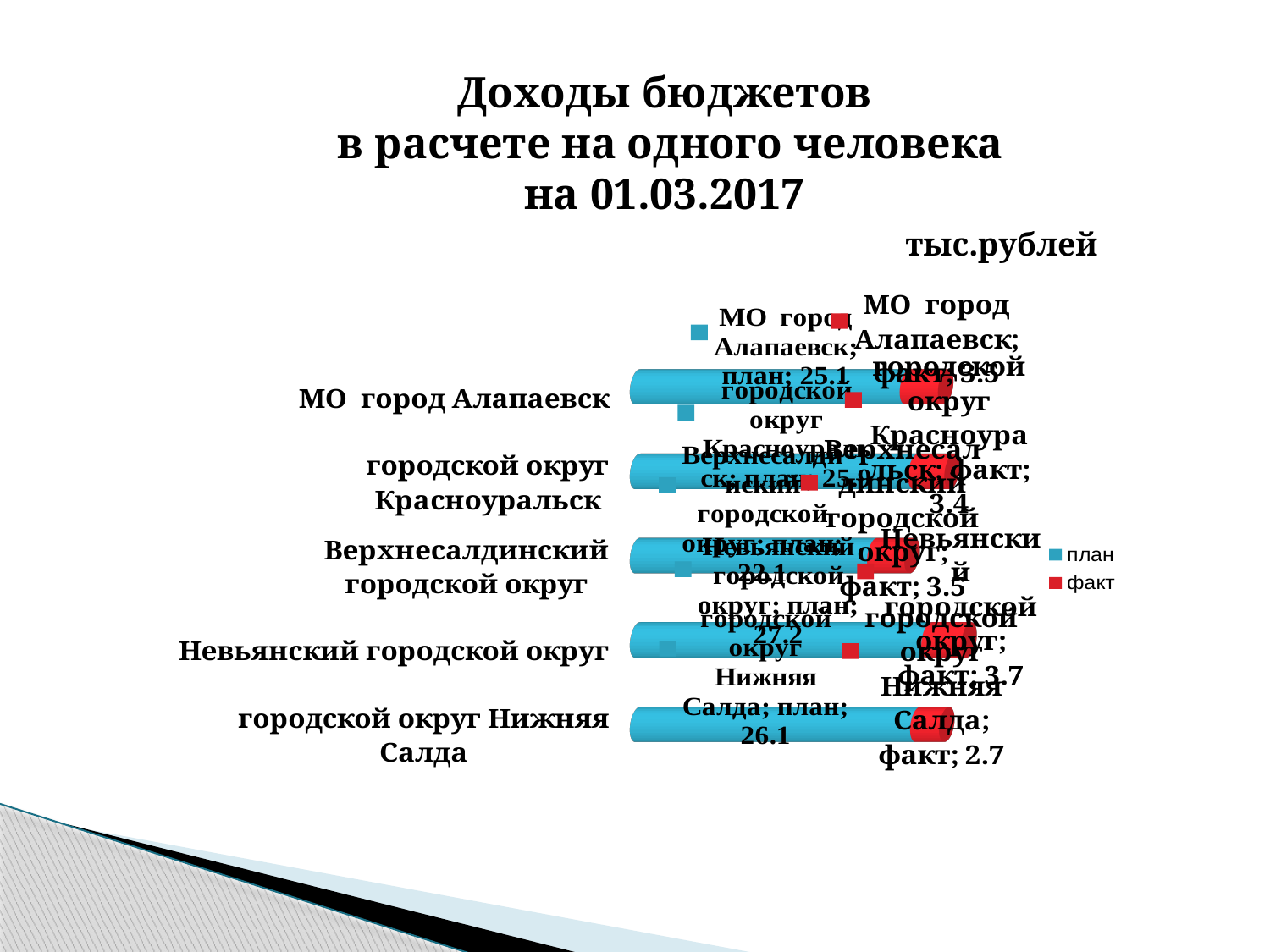
How many categories (municipalities) are shown on the chart? 5 What kind of chart is shown on the slide? bar chart What is the план value for Невьянский городской округ? 27.2 Which is larger for городской округ Нижняя Салда, план or факт? план What is the план value for МО город Алапаевск? 25.1 What is the план value for городской округ Нижняя Салда? 26.1 What is the difference between план and факт for Невьянский городской округ? 23.5 What are the two series named in the legend? план and факт What is the факт value for Невьянский городской округ? 3.7 What is the факт value for городской округ Нижняя Салда? 2.7 Which category has the lowest факт value? городской округ Нижняя Салда How many series does the legend list? 2